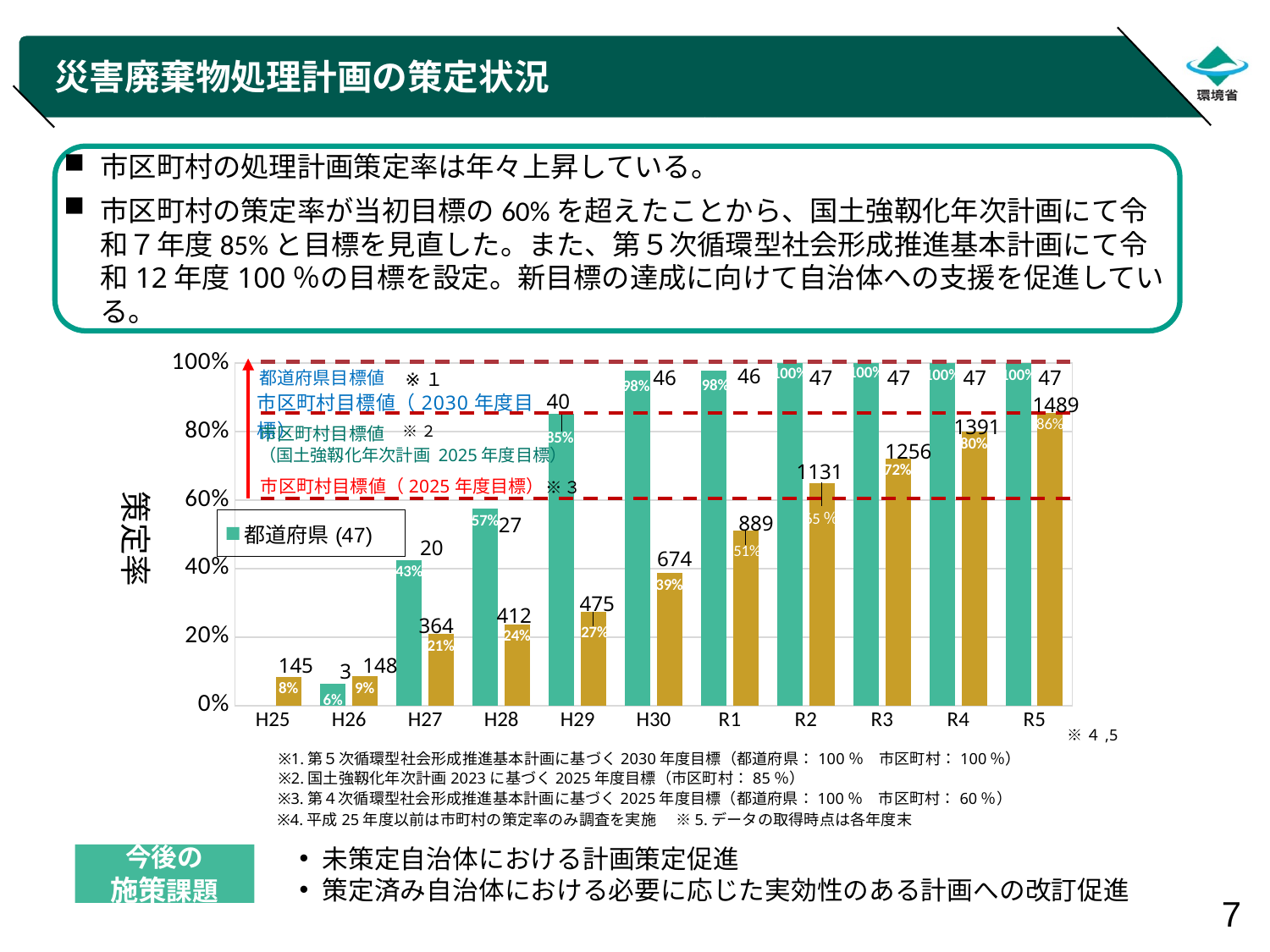
What is the number label on the green 都道府県 bar for H29? 40 Which fiscal year has the highest gold bar? R5 What is the difference between the gold bar number labels for R5 and R4? 98 What percentage is printed inside the gold bar for R5? 86% Which fiscal year has the lowest green 都道府県 bar? H26 What is the number label on the gold bar for R5? 1489 How many fiscal-year categories are shown on the x axis of the chart? 11 Which is larger, the gold bar number label for H30 or for R1? R1 What is the number label on the gold bar for H25? 145 What percentage is printed inside the green 都道府県 bar for H29? 85% Do the gold bars rise or fall from H25 to R5? rise What kind of chart is shown on the slide? bar chart